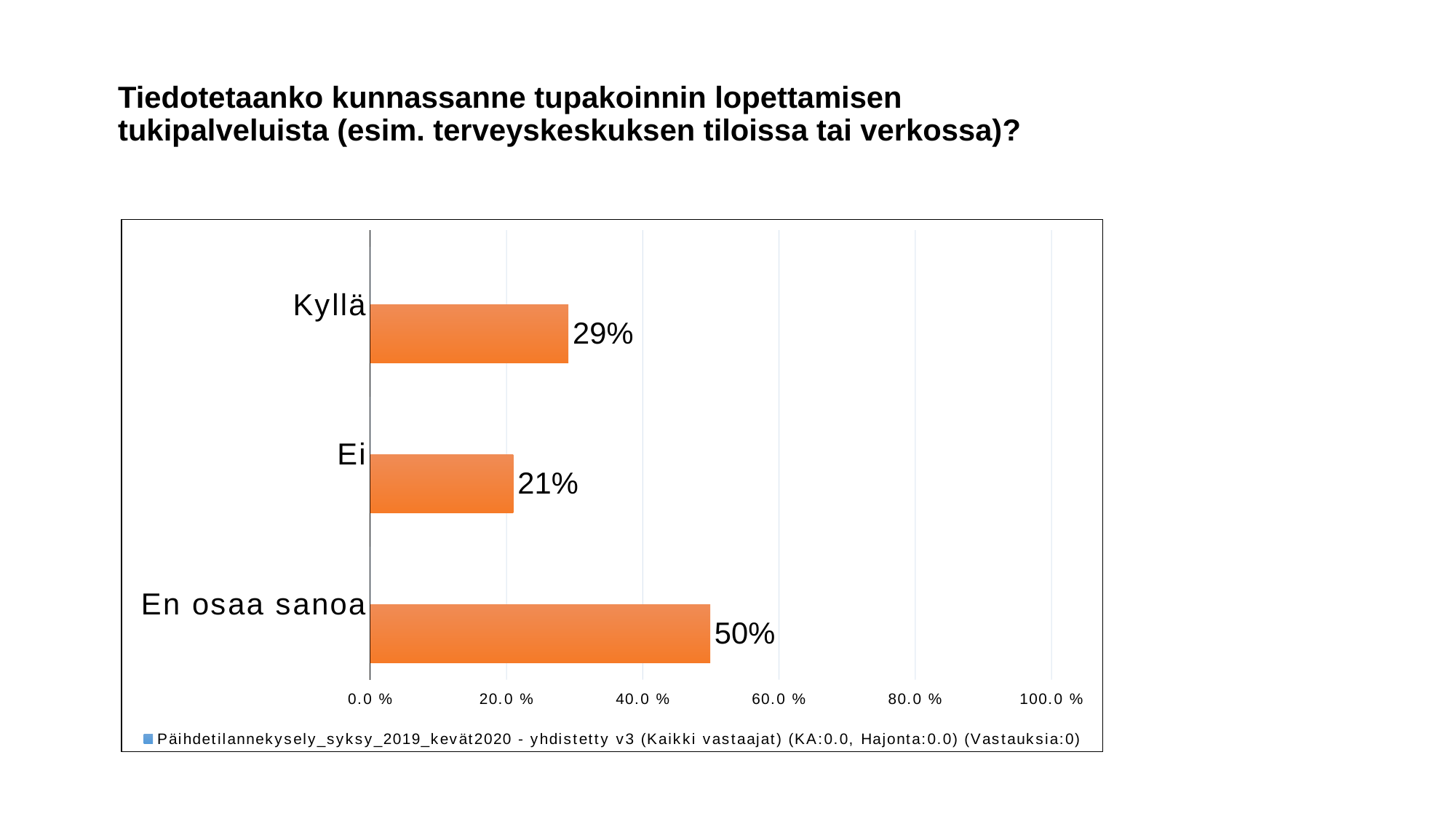
Is the value for En osaa sanoa greater or less than 40.0 %? greater Which category has the lowest value? Ei What is the highest value shown on the x axis? 100.0 % What is the value for Kyllä? 29% What is the difference between the values for En osaa sanoa and Kyllä? 21% What is the value for En osaa sanoa? 50% What is the difference between the values for Kyllä and Ei? 8% Which is larger, the value for Kyllä or the value for Ei? Kyllä How many categories are shown in the chart? 3 What kind of chart is shown on the slide? bar chart Which category has the highest value? En osaa sanoa What is the value for Ei? 21%